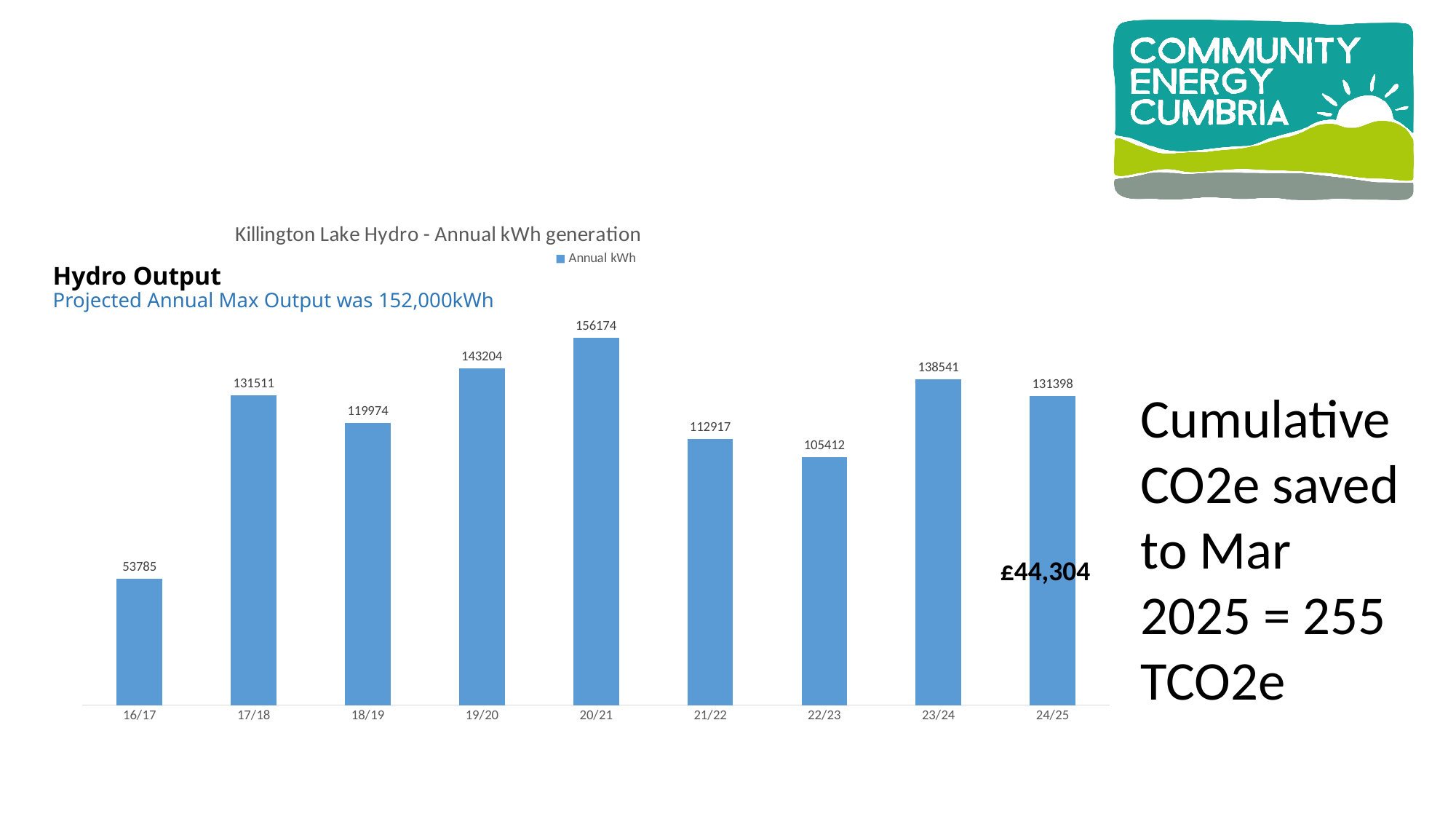
How many years are shown on the x axis of the chart? 9 What kind of chart is shown on the slide? bar chart Which is larger, the value for 19/20 or the value for 18/19? 19/20 How many series does the legend list? 1 What is the difference between the values for 23/24 and 24/25? 7143 What is the title of the chart? Killington Lake Hydro - Annual kWh generation Which year has the lowest annual kWh generation? 16/17 What is the value for 16/17 in the chart? 53785 What is the difference between the values for 20/21 and 16/17? 102389 Which year has the highest annual kWh generation? 20/21 What is the value for 22/23 in the chart? 105412 What is the value for 20/21 in the Killington Lake Hydro annual kWh generation chart? 156174